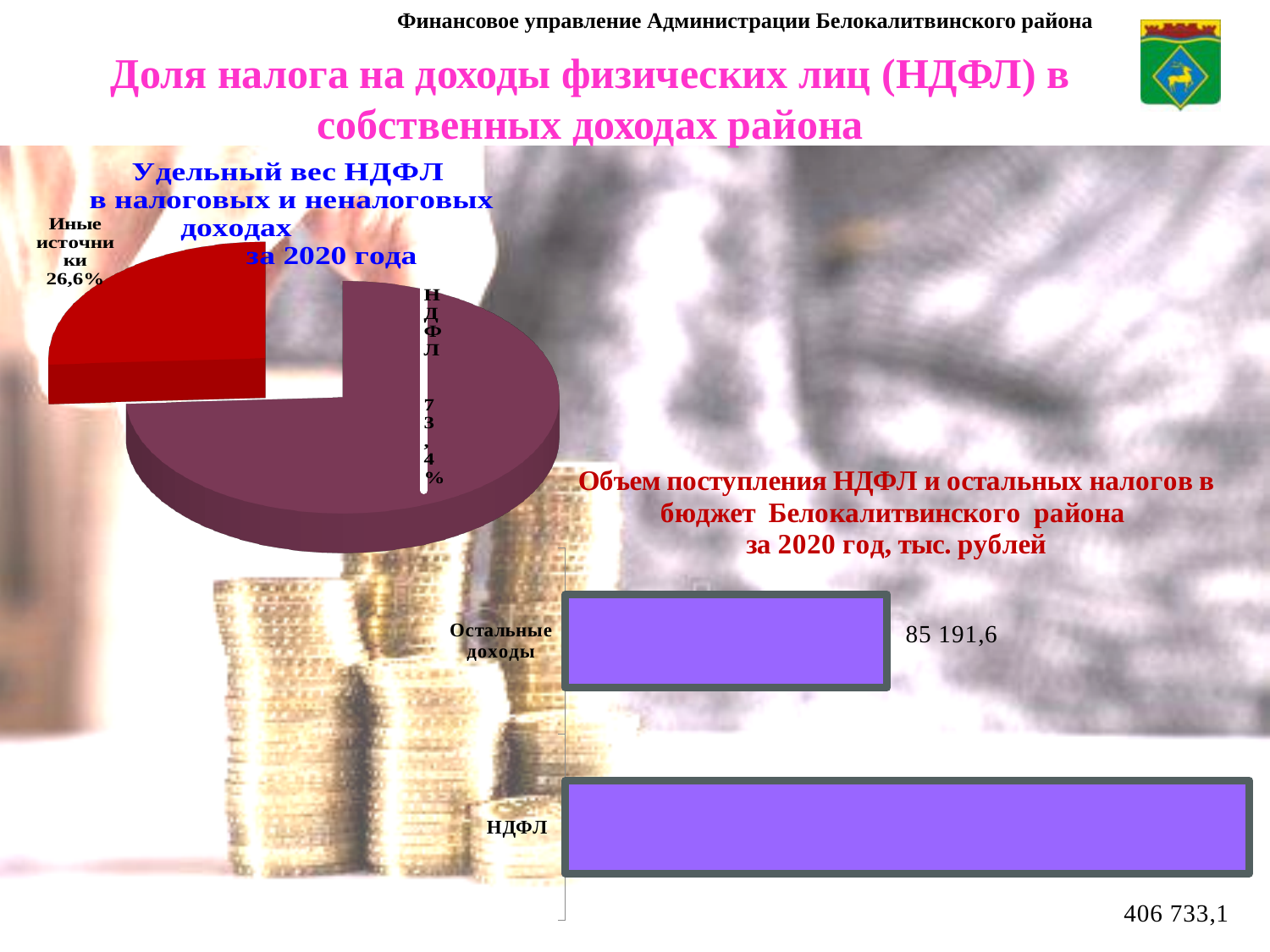
On the bar chart 'Объем поступления НДФЛ и остальных налогов', which category has the highest value? НДФЛ On the bar chart 'Объем поступления НДФЛ и остальных налогов', which category has the lowest value? Остальные доходы On the bar chart 'Объем поступления НДФЛ и остальных налогов', what is the value for Остальные доходы? 85 191,6 What kind of chart is the chart at the bottom right of the slide? bar chart On the bar chart 'Объем поступления НДФЛ и остальных налогов', what is the value for НДФЛ? 406 733,1 In what units are the values on the bar chart 'Объем поступления НДФЛ и остальных налогов' given? тыс. рублей On the pie chart, what share does НДФЛ have? 73,4% What kind of chart is the chart on the left of the slide? pie chart On the pie chart, what share do Иные источники have? 26,6% How many slices does the pie chart have? 2 On the bar chart 'Объем поступления НДФЛ и остальных налогов', what is the difference between НДФЛ and Остальные доходы? 321 541,5 On the pie chart, which slice is larger, НДФЛ or Иные источники? НДФЛ